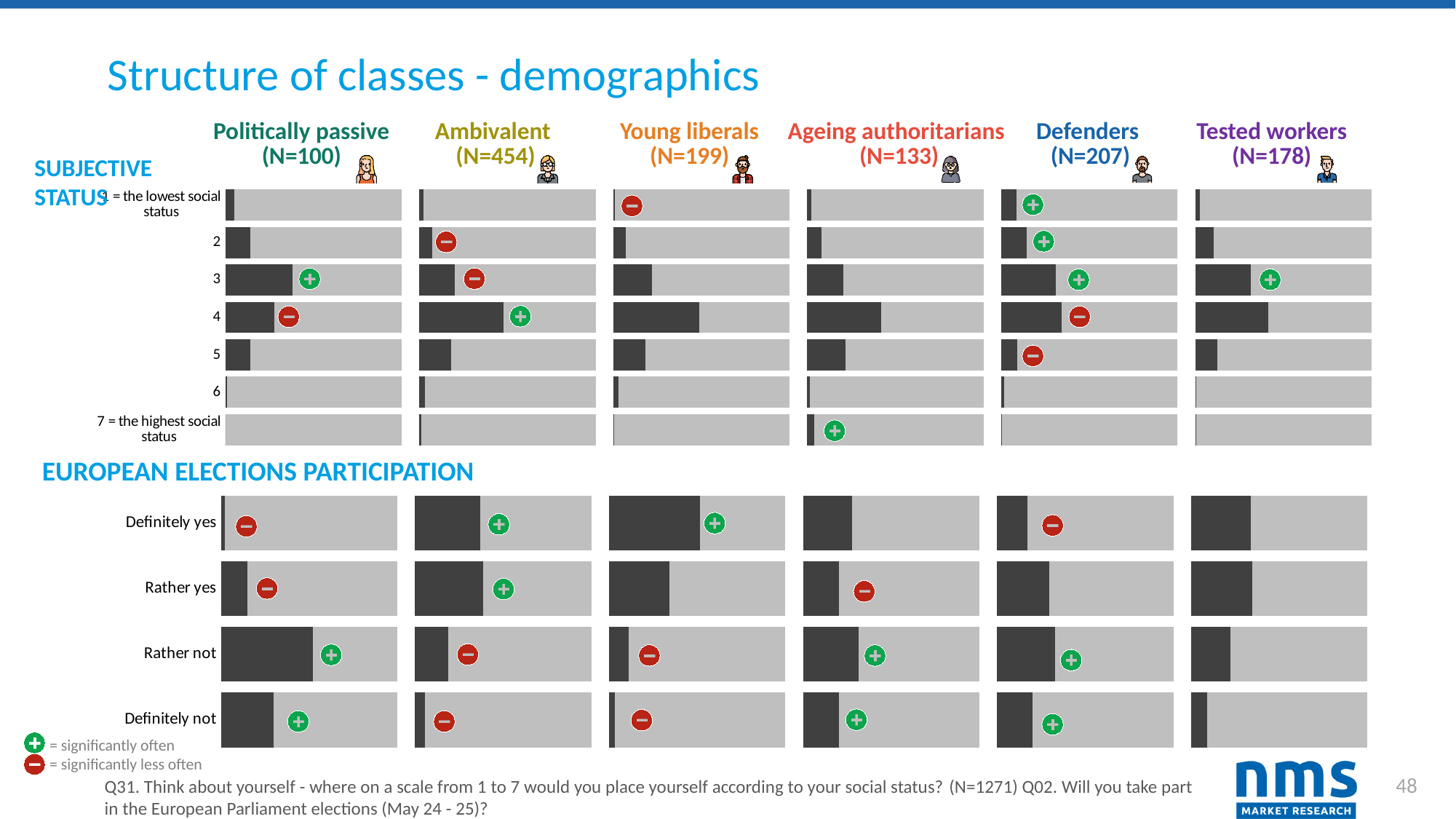
In the European Elections Participation chart, which answer has the shortest bar for the Ambivalent class? Definitely not How many classes (columns) are compared across the charts on this slide? 6 How many answer categories are shown in the European Elections Participation chart? 4 How many social status levels (categories) are shown in the Subjective Status chart? 7 According to the legend, what does the green plus symbol indicate? significantly often In the European Elections Participation chart, which answer has the longest bar for the Young liberals class? Definitely yes What is the sample size (N) shown for the Ambivalent class? N=454 In the Subjective Status chart, which status level has the longest bar for the Young liberals class? 4 In the Subjective Status chart, which status level has the longest bar for the Ambivalent class? 4 In the European Elections Participation chart for Young liberals, which bar is longer: Definitely yes or Rather yes? Definitely yes What kind of chart is used to show the subjective status distribution on this slide? bar chart